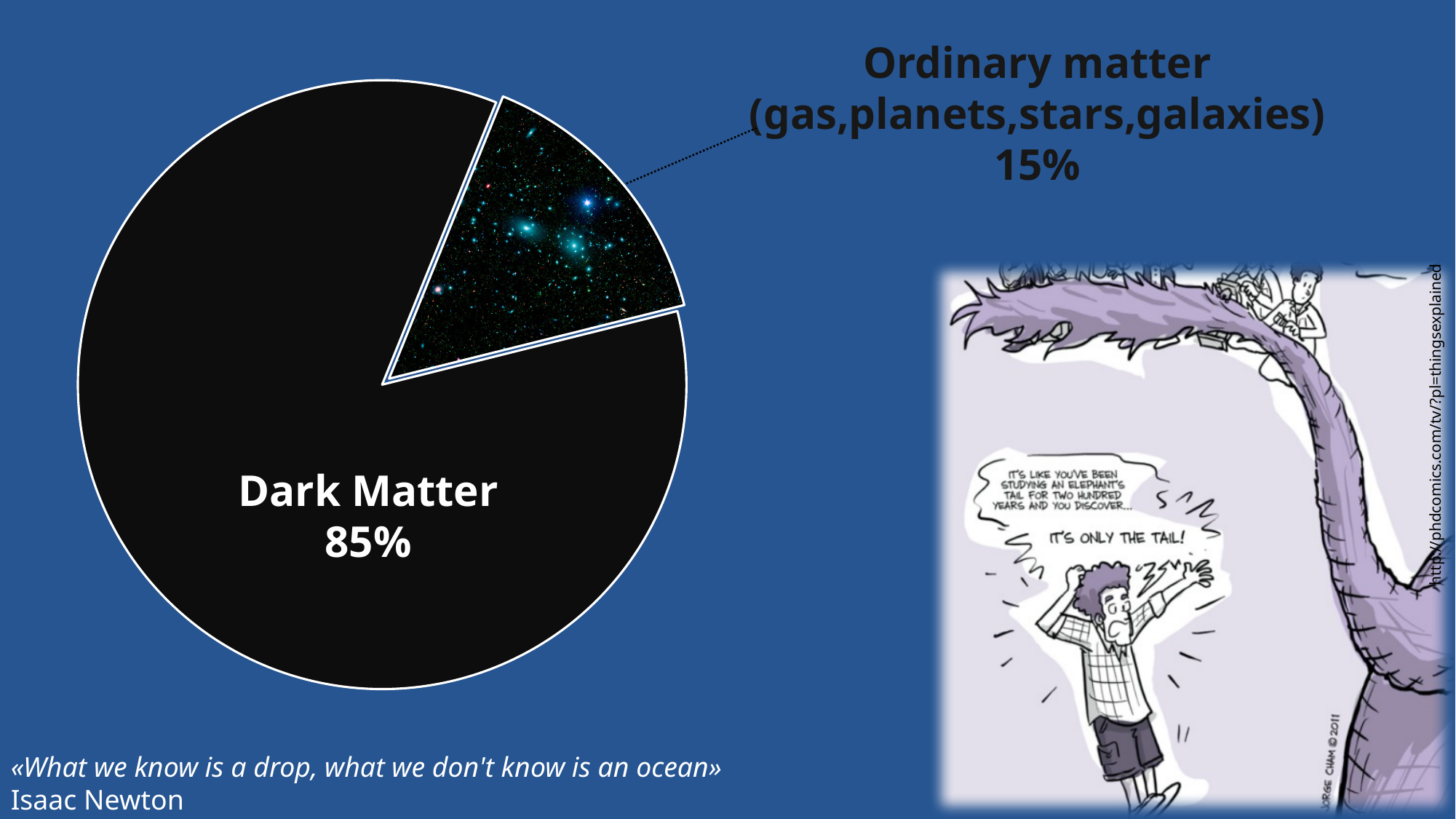
What examples of ordinary matter are listed in the label of the smaller slice? gas, planets, stars, galaxies What share of the pie chart is Dark Matter? 85% What kind of chart is shown on the slide? Pie chart Is the Dark Matter share greater or less than 50%? greater Which slice of the pie chart is the largest? Dark Matter Which is larger, the Dark Matter slice or the Ordinary matter slice? Dark Matter What colour is the Dark Matter slice of the pie chart? Black How many slices does the pie chart have? 2 Which slice of the pie chart is the smallest? Ordinary matter What do the two slices of the pie chart add up to? 100% What share of the pie chart is Ordinary matter (gas, planets, stars, galaxies)? 15% What is the difference in percentage points between the Dark Matter slice and the Ordinary matter slice? 70